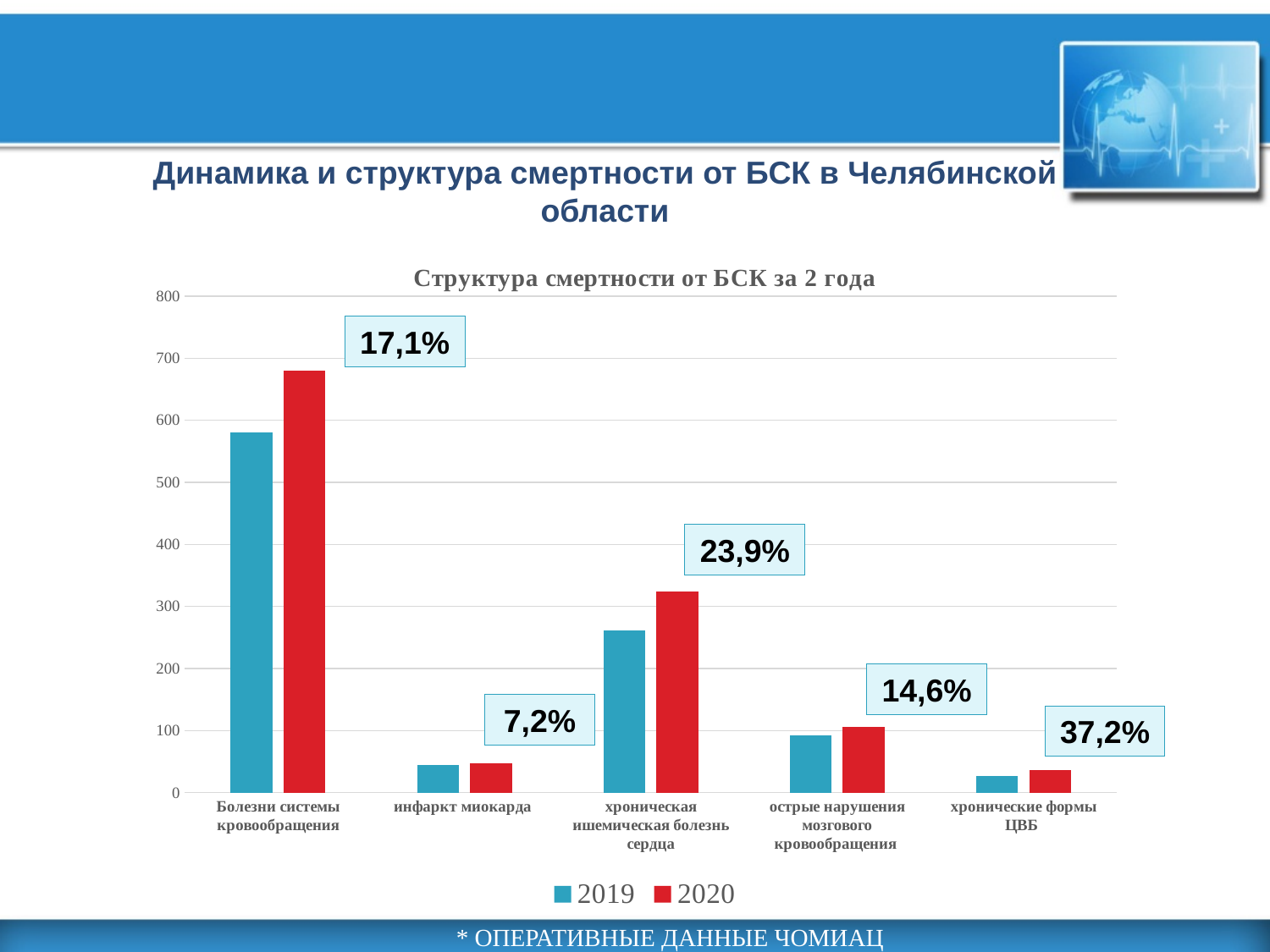
For Болезни системы кровообращения, which year has the larger value, 2019 or 2020? 2020 Is the 2020 value for хроническая ишемическая болезнь сердца greater or less than 300? greater Is the 2019 value for хроническая ишемическая болезнь сердца greater or less than 300? less Is the 2020 value for Болезни системы кровообращения greater or less than 600? greater Which category has the lowest 2019 bar? хронические формы ЦВБ What is the title of the chart? Структура смертности от БСК за 2 года How many categories are shown on the x axis of the chart? 5 How many series does the legend of the chart list? 2 Which category has the highest 2020 bar? Болезни системы кровообращения Which is larger in 2020: хроническая ишемическая болезнь сердца or острые нарушения мозгового кровообращения? хроническая ишемическая болезнь сердца What kind of chart is shown on the slide? bar chart